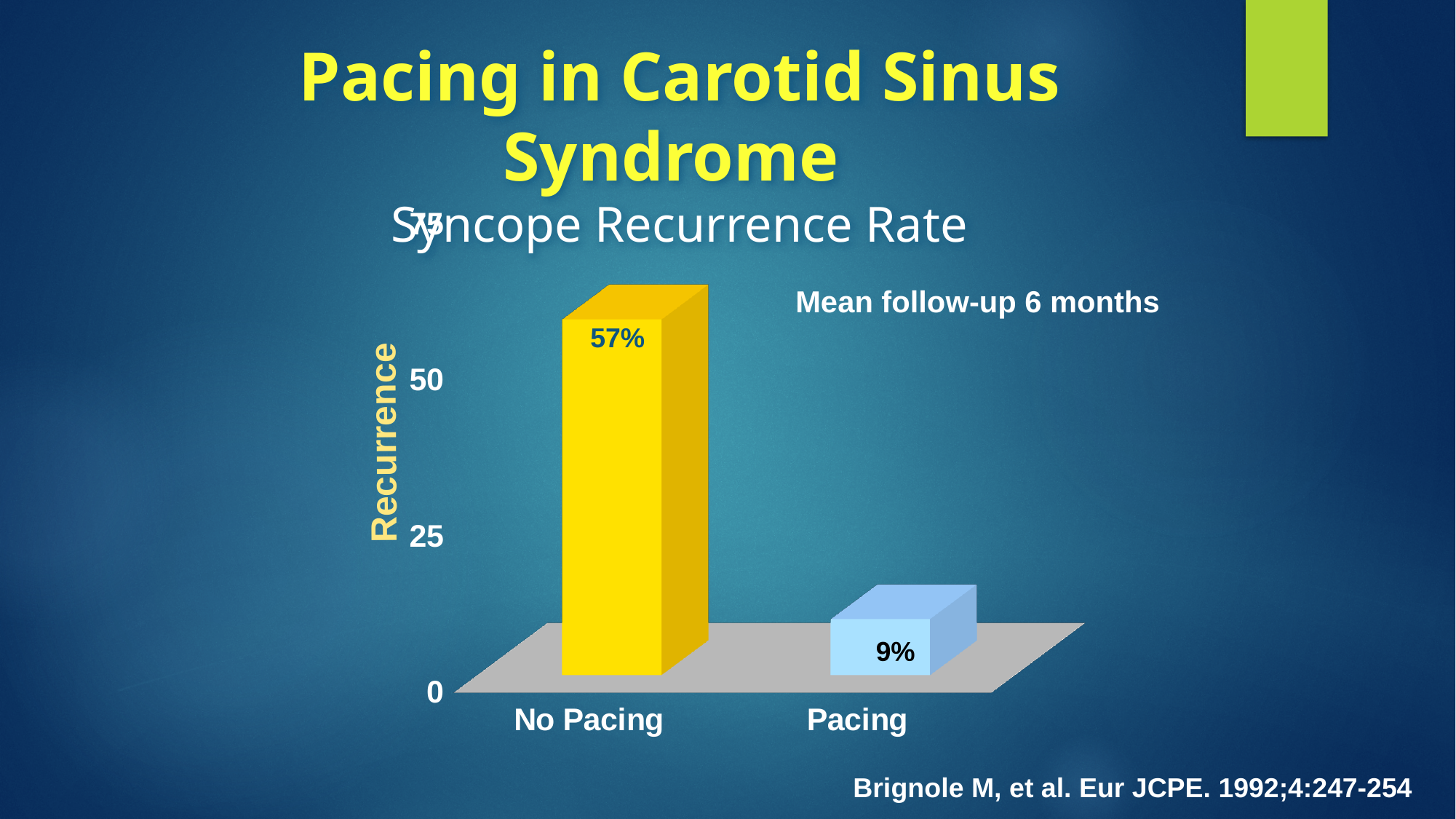
What is the syncope recurrence rate for Pacing? 9% What kind of chart is shown on the slide? Bar chart What is the mean follow-up period noted on the chart? 6 months What is the difference in recurrence rate between No Pacing and Pacing? 48% Is the recurrence rate for No Pacing greater or less than 50? greater How many categories are shown on the chart? 2 Which category has the higher recurrence rate? No Pacing Which category has the lower recurrence rate? Pacing What is the syncope recurrence rate for No Pacing? 57% Is the recurrence rate for Pacing greater or less than 25? less What is the label on the vertical axis of the chart? Recurrence